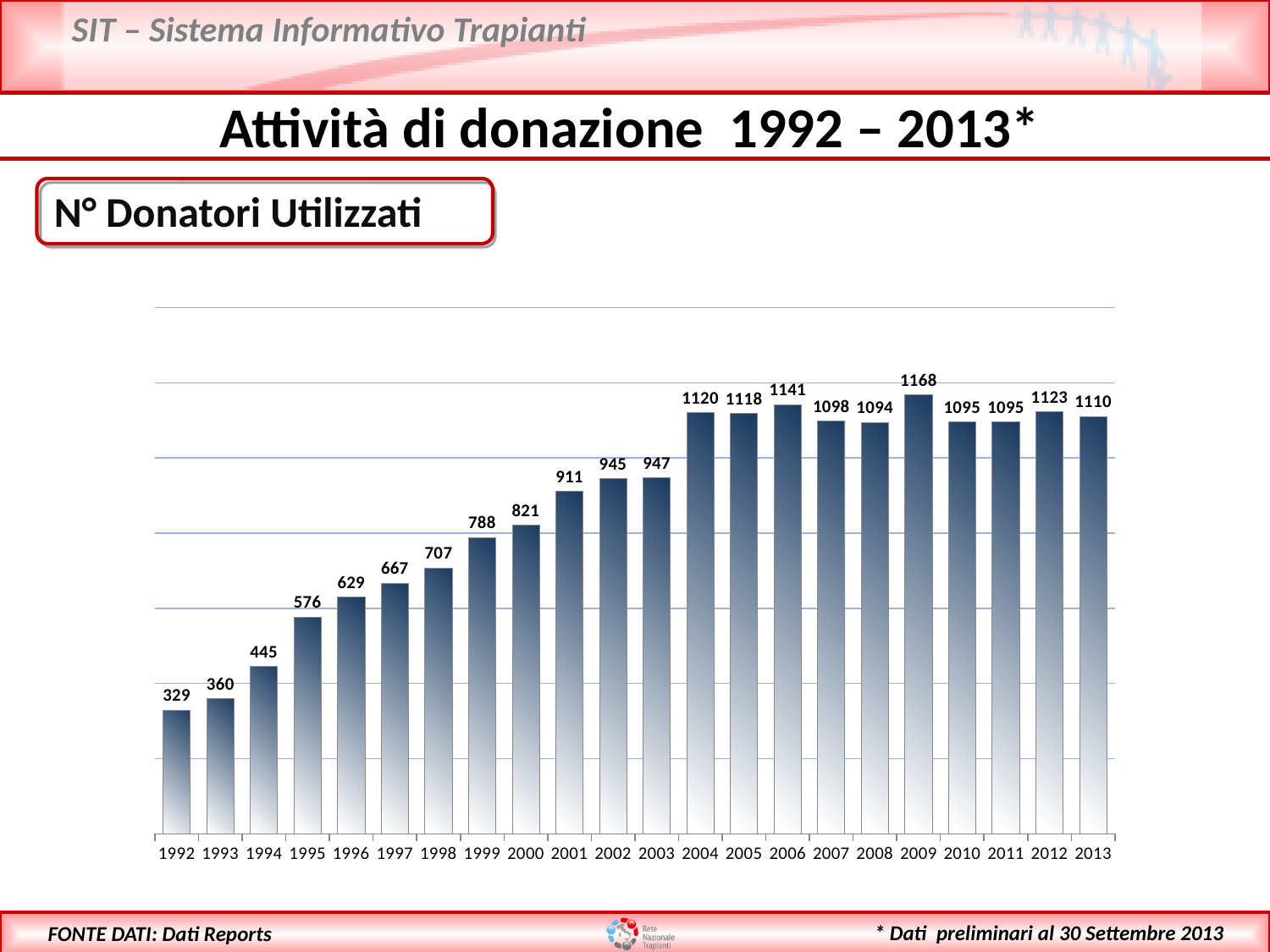
What is the value shown for 2013? 1110 What is the number of donors used (N° Donatori Utilizzati) in 1992? 329 What kind of chart is shown on the slide? Bar chart Which year has a larger value, 2004 or 2008? 2004 What is the difference between the values for 2006 and 2007? 43 What is the value shown for 2001? 911 What is the difference between the values for 2013 and 1992? 781 How many years are shown on the x axis of the chart? 22 Which year has the highest number of donors used? 2009 What is the value shown for 2009? 1168 Do the values generally rise or fall from 1992 to 2004? Rise Which year has the lowest number of donors used? 1992